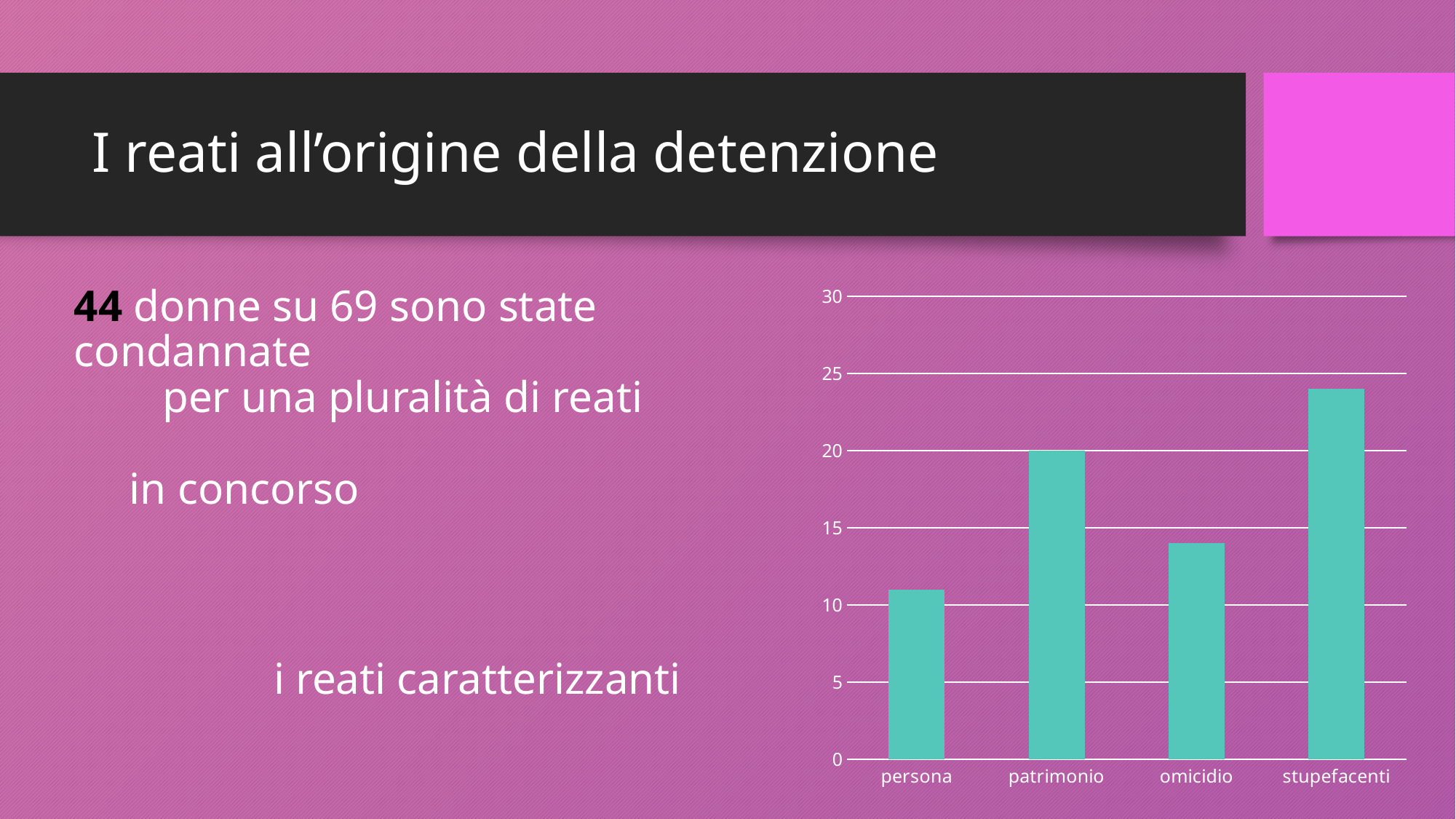
Is the value for persona greater or less than 15? less Is the value for omicidio greater or less than 15? less How many categories are shown on the x axis of the chart? 4 Is the value for stupefacenti greater or less than 20? greater Which category has the lowest bar in the chart? persona What is the value for patrimonio in the chart? 20 Which is larger, the value for persona or the value for stupefacenti? stupefacenti Which category has the highest bar in the chart? stupefacenti What kind of chart is shown on the slide? bar chart Which is larger, the value for patrimonio or the value for omicidio? patrimonio What colour are the bars in the chart? teal